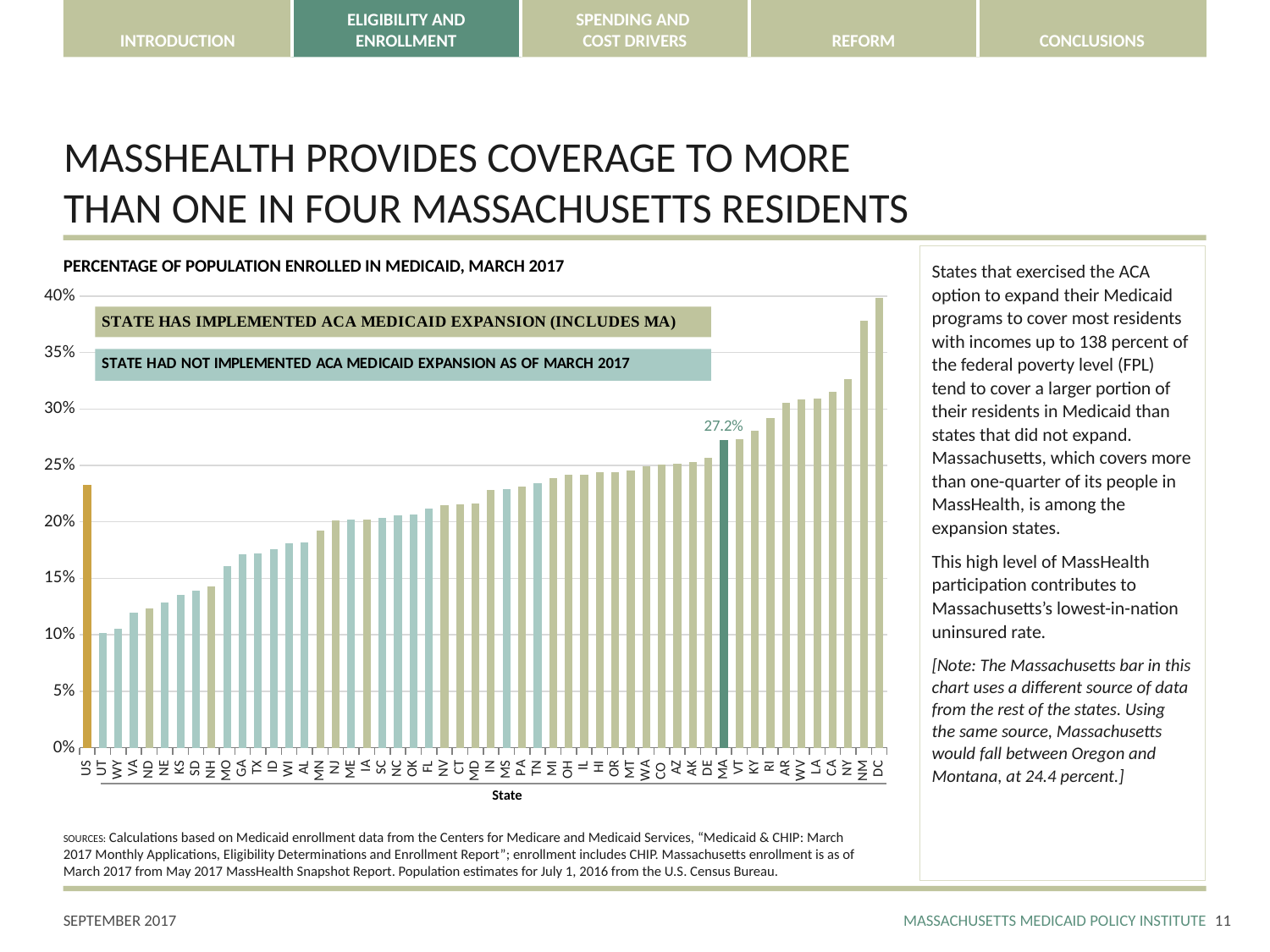
Which state has the highest percentage of population enrolled in Medicaid? DC What is the title of the chart? Percentage of Population Enrolled in Medicaid, March 2017 Is the value for UT greater or less than 15%? less Is the value for TX greater or less than 20%? less What is the percentage of population enrolled in Medicaid for MA? 27.2% Which has a higher percentage of population enrolled in Medicaid, NY or CA? NY Is the value for US greater or less than 20%? greater Which state has the lowest percentage of population enrolled in Medicaid? UT What kind of chart is shown on the slide? Bar chart What is the label on the x axis of the chart? State Do the values generally rise or fall moving from left to right along the x axis? Rise